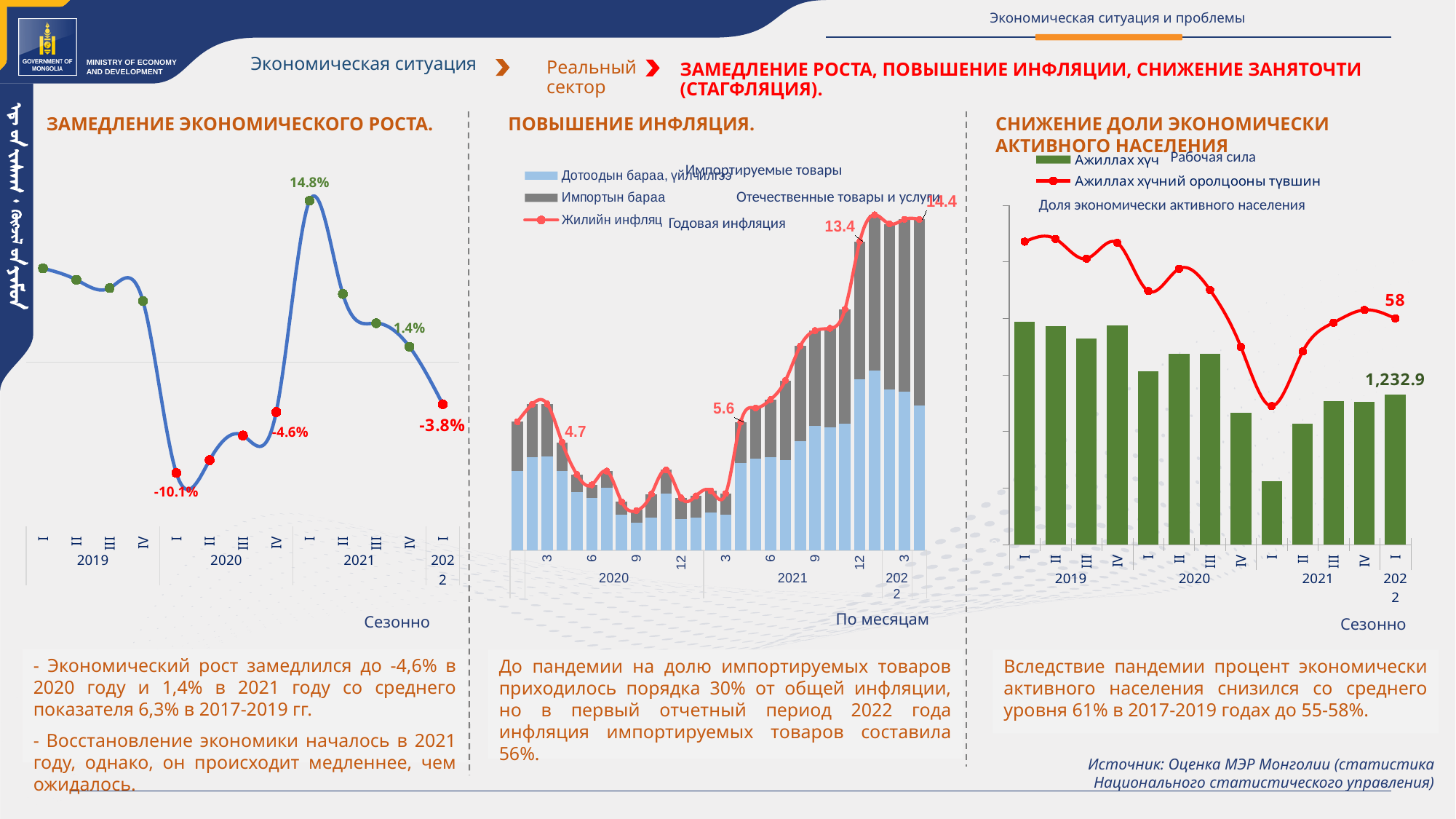
In the left chart (ЗАМЕДЛЕНИЕ ЭКОНОМИЧЕСКОГО РОСТА), which quarter has the lowest value? I 2020 In the middle chart (ПОВЫШЕНИЕ ИНФЛЯЦИЯ), what is the highest labelled value of the annual inflation line? 14.4 In the left chart (ЗАМЕДЛЕНИЕ ЭКОНОМИЧЕСКОГО РОСТА), what value is labelled for quarter I of 2020? -10.1% In the left chart (ЗАМЕДЛЕНИЕ ЭКОНОМИЧЕСКОГО РОСТА), which quarter has the highest value? I 2021 In the left chart (ЗАМЕДЛЕНИЕ ЭКОНОМИЧЕСКОГО РОСТА), what value is labelled for quarter I of 2022? -3.8% In the middle chart (ПОВЫШЕНИЕ ИНФЛЯЦИЯ), what is the difference between the labelled inflation values 14.4 and 4.7? 9.7 In the left chart (ЗАМЕДЛЕНИЕ ЭКОНОМИЧЕСКОГО РОСТА), what is the difference between the labelled values for quarter I of 2021 and quarter IV of 2021? 13.4 percentage points In the right chart (СНИЖЕНИЕ ДОЛИ ЭКОНОМИЧЕСКИ АКТИВНОГО НАСЕЛЕНИЯ), what value is labelled on the labour force bar for quarter I of 2022? 1,232.9 In the middle chart (ПОВЫШЕНИЕ ИНФЛЯЦИЯ), how many series does the legend list? 3 In the left chart (ЗАМЕДЛЕНИЕ ЭКОНОМИЧЕСКОГО РОСТА), how many quarterly data points are plotted? 13 In the right chart (СНИЖЕНИЕ ДОЛИ ЭКОНОМИЧЕСКИ АКТИВНОГО НАСЕЛЕНИЯ), which quarter has the lowest labour force bar? I 2021 In the left chart (ЗАМЕДЛЕНИЕ ЭКОНОМИЧЕСКОГО РОСТА), what value is labelled for quarter I of 2021? 14.8%